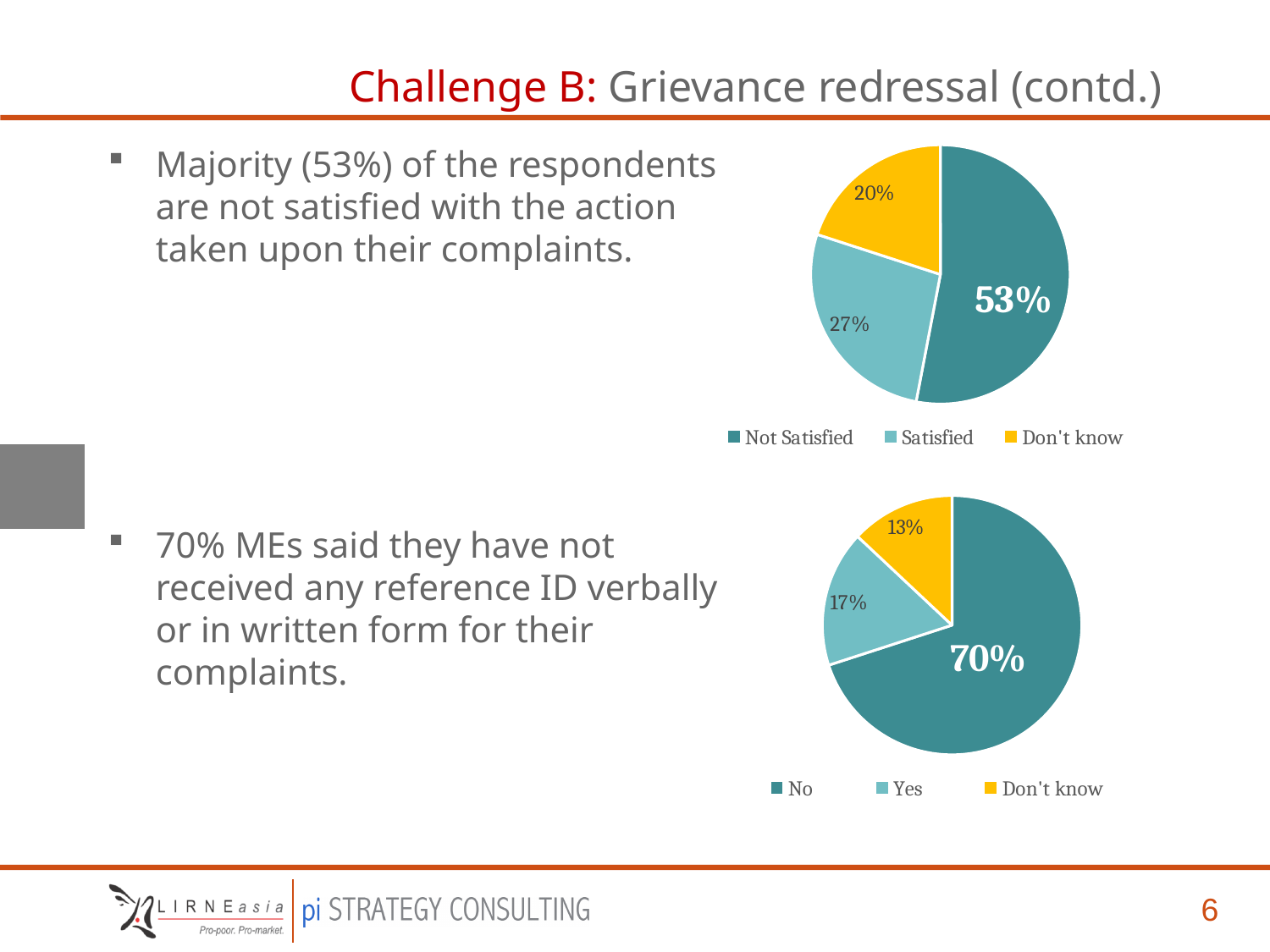
In the bottom pie chart, what share of MEs answered Yes? 17% How many categories does the legend of the bottom pie chart list? 3 In the top pie chart, which category has the largest slice? Not Satisfied In the bottom pie chart, what share answered Don't know? 13% In the top pie chart, what share of respondents are Not Satisfied? 53% In the bottom pie chart, what share of MEs answered No? 70% In the top pie chart, what is the difference between the Not Satisfied and Satisfied shares? 26% In the top pie chart, what share of respondents answered Don't know? 20% What type of chart is used for the top chart on the slide? Pie chart In the top pie chart, what share of respondents are Satisfied? 27% In the top pie chart, which category has the smallest slice? Don't know In the bottom pie chart, which is larger, Yes or Don't know? Yes